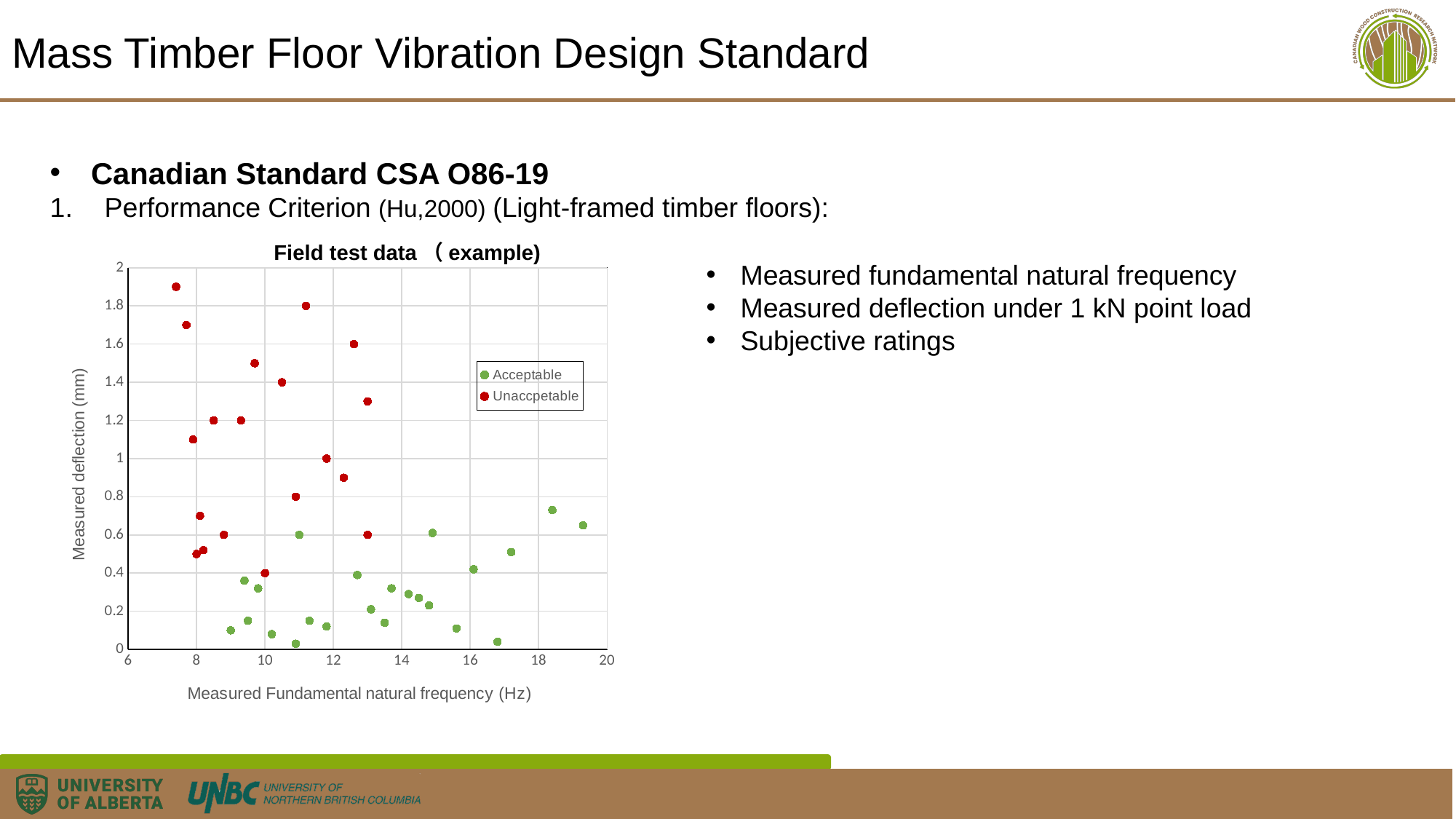
How many series does the legend of the chart list? 2 What is the title of the chart? Field test data (example) Is the measured deflection of the highest Unaccpetable point greater or less than 1.8? greater What kind of chart is shown on the slide? Scatter chart Which series in the chart is plotted with red markers? Unaccpetable Which series contains the point with the highest measured deflection? Unaccpetable Is the measured deflection of the lowest Acceptable point greater or less than 0.2? less What is the maximum value shown on the horizontal axis of the chart? 20 Are all Acceptable points below a measured deflection of 1 mm? Yes Which series contains the point with the highest measured fundamental natural frequency? Acceptable